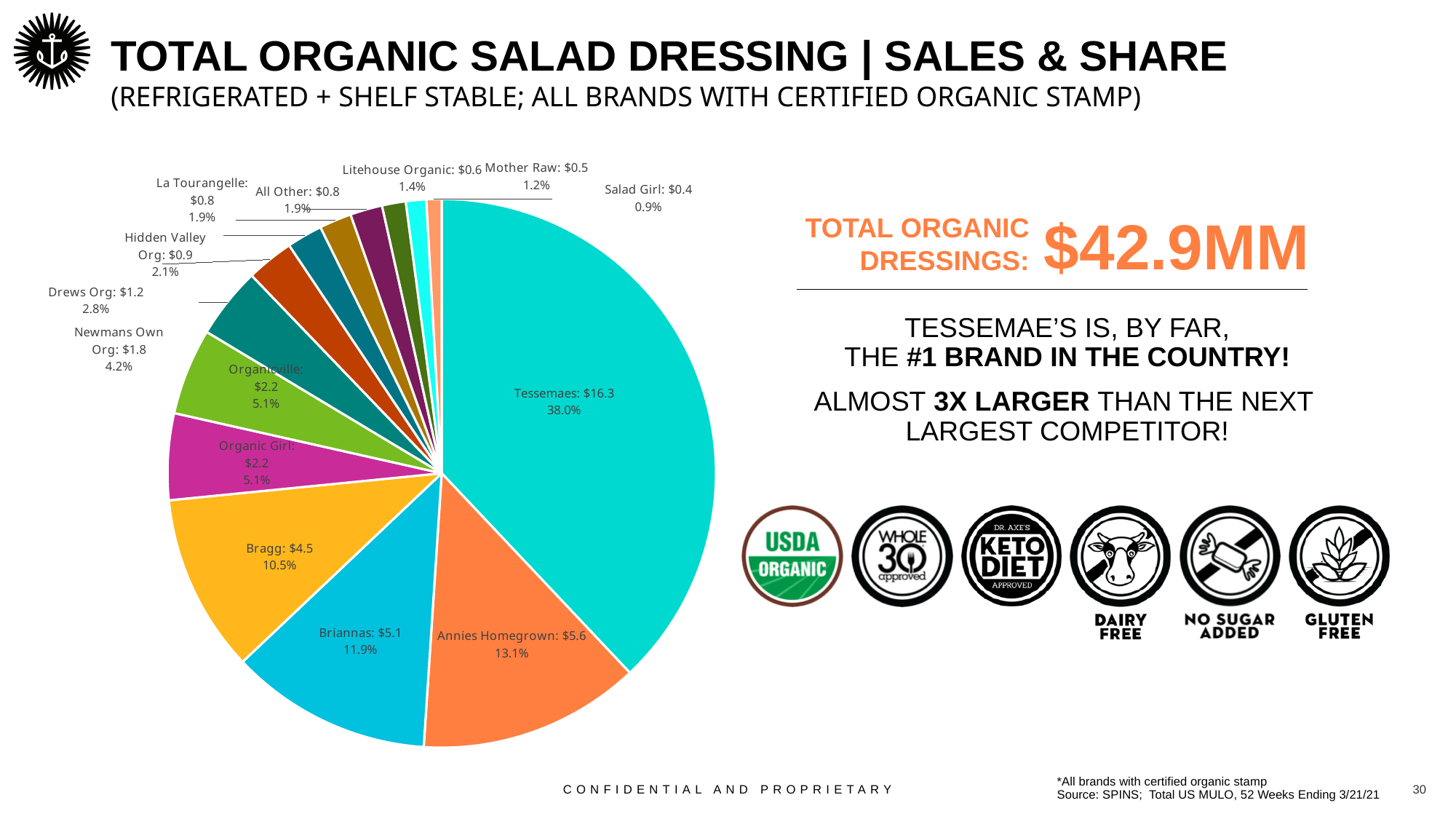
What share of the pie does Annies Homegrown hold? 13.1% Which brand has the smallest slice of the pie? Salad Girl What share of the pie does Newmans Own Org hold? 4.2% What are the sales for Tessemaes in the pie chart? $16.3 What is the difference in sales between Tessemaes and Annies Homegrown? $10.7 What kind of chart is shown on the slide? Pie chart What total organic dressings sales figure is stated on the slide? $42.9MM How many slices does the pie chart have? 14 What are the sales for Drews Org in the pie chart? $1.2 Which brand has the largest slice of the pie? Tessemaes What are the sales for Bragg in the pie chart? $4.5 Which has higher sales, Briannas or Bragg? Briannas